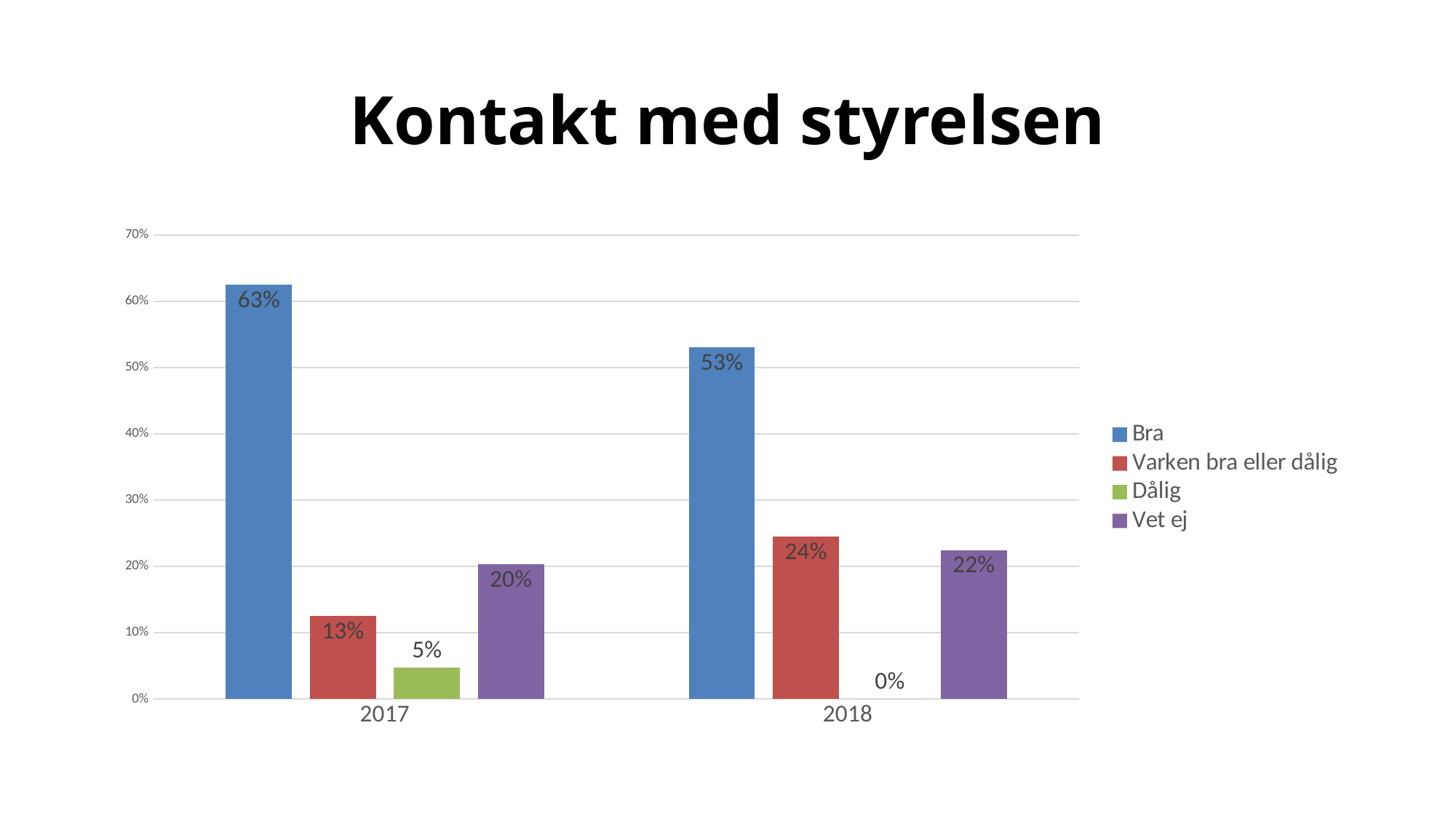
Which series has the highest value in 2018? Bra Which series has the lowest value in 2017? Dålig What is the value for Vet ej in 2017? 20% What is the title of the chart? Kontakt med styrelsen What is the value for Bra in 2017? 63% What kind of chart is shown on the slide? Bar chart What is the difference between the Bra values for 2017 and 2018? 10% What is the value for Dålig in 2018? 0% Which is larger: Vet ej in 2017 or Vet ej in 2018? Vet ej in 2018 How many series does the legend list? 4 What is the value for Varken bra eller dålig in 2018? 24% How many categories are shown on the x axis? 2